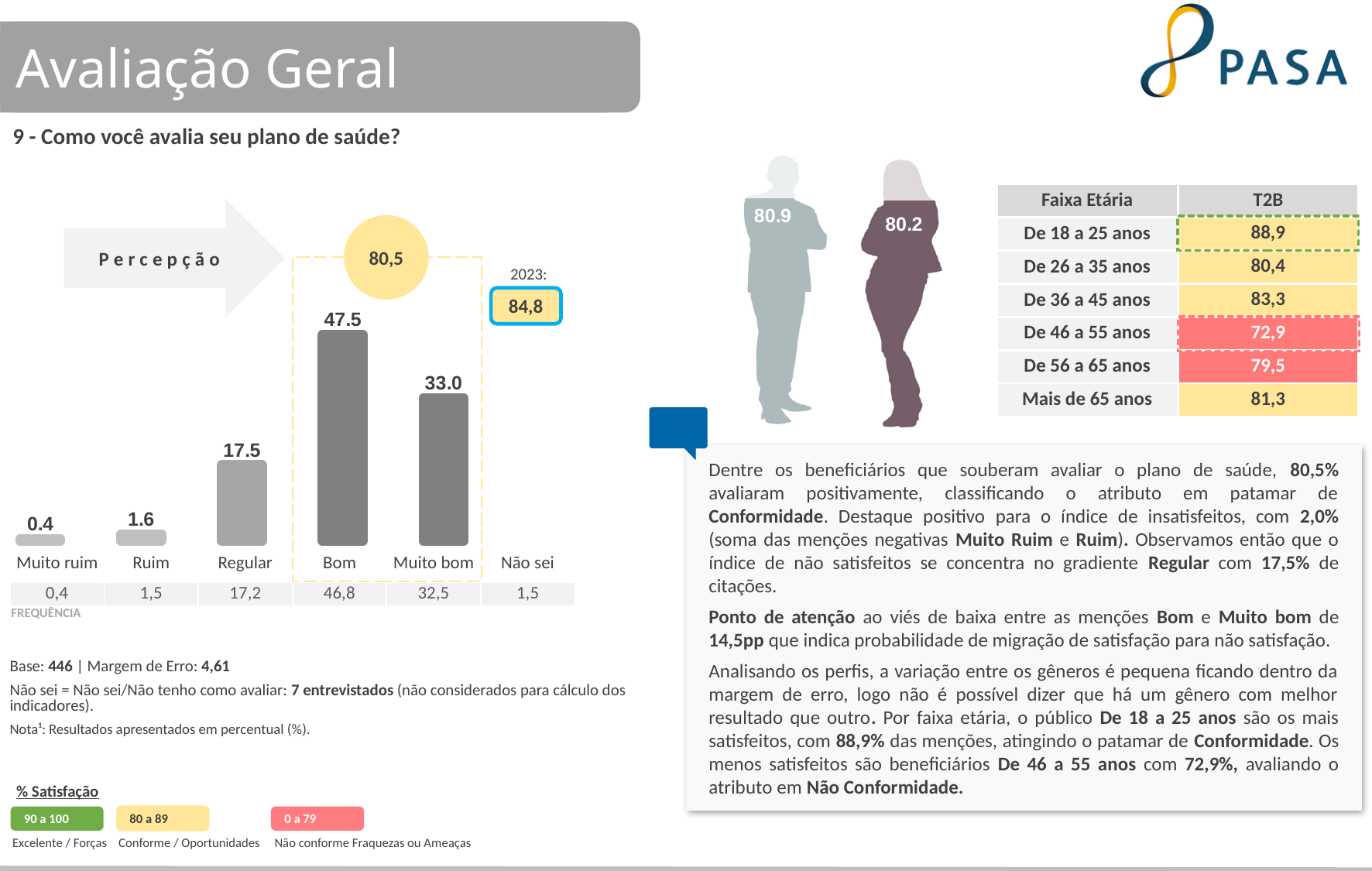
What type of chart is shown on the slide? bar chart What value is shown in the yellow circle above the 'Bom' and 'Muito bom' bars? 80,5 What is the value shown for the 'Bom' bar? 47.5 How many bars are plotted in the chart? 5 Which category has the lowest bar? Muito ruim Which is larger, the value for 'Regular' or the value for 'Muito bom'? Muito bom What is the difference between the 'Bom' and 'Muito bom' values? 14.5 What is the value shown for the 'Ruim' bar? 1.6 What is the value shown for the 'Muito bom' bar? 33.0 What is the difference between the 'Regular' and 'Ruim' values? 15.9 What is the value shown for the 'Regular' bar? 17.5 Which category has the highest bar? Bom